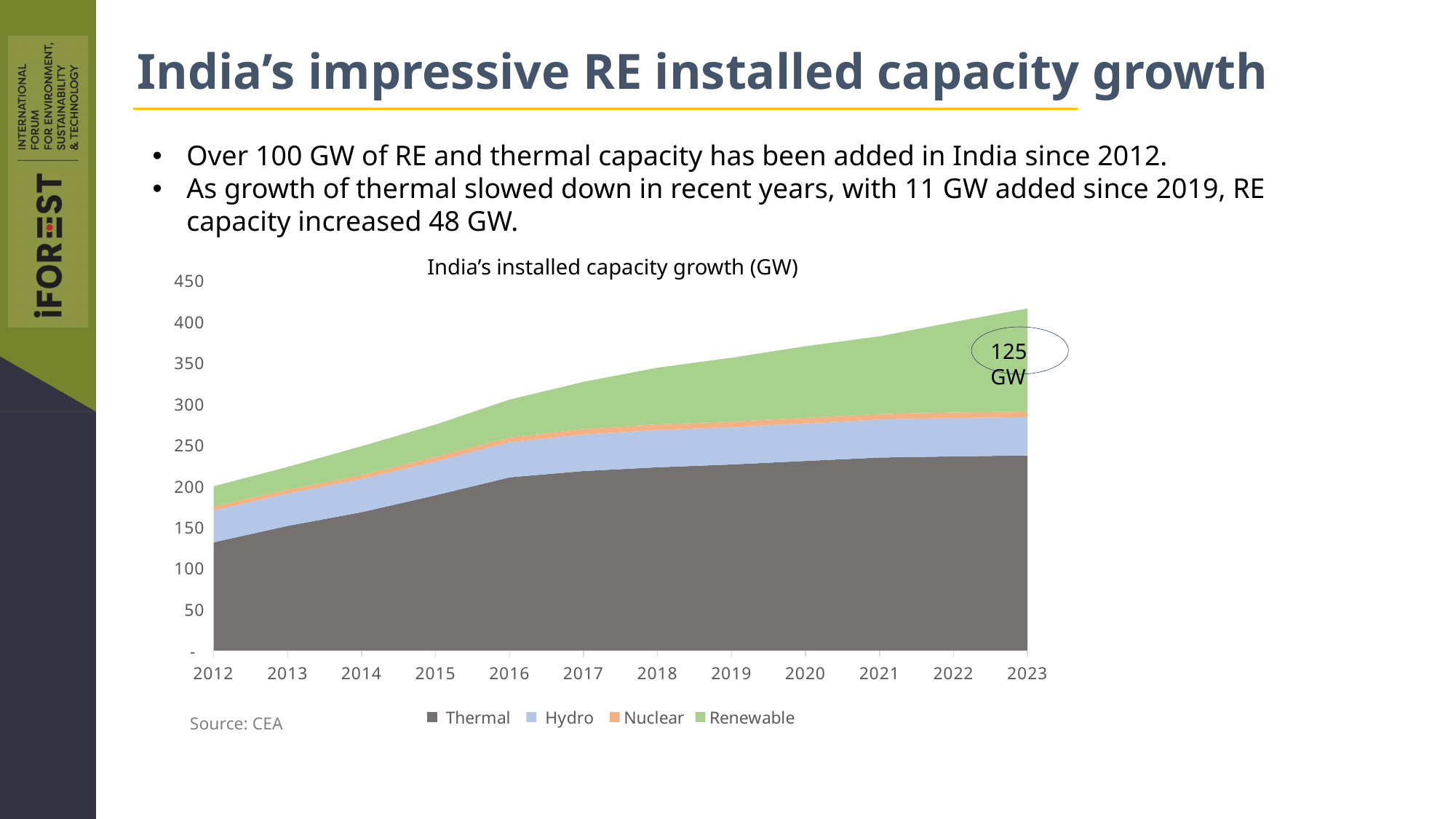
In 2023, which is larger: Thermal capacity or Renewable capacity? Thermal In which year is total installed capacity highest? 2023 How many years are shown along the x axis of the chart? 12 Is the Thermal capacity in 2012 greater or less than 150? less Does total installed capacity rise or fall from 2012 to 2023? Rise Is the total installed capacity in 2023 greater or less than 400? greater How many series does the chart legend list? 4 In which year is total installed capacity lowest? 2012 What kind of chart is shown on the slide? Stacked area chart Which series is shown in green in the chart? Renewable What value is annotated for Renewable capacity in 2023? 125 GW What is the title of the chart? India's installed capacity growth (GW)